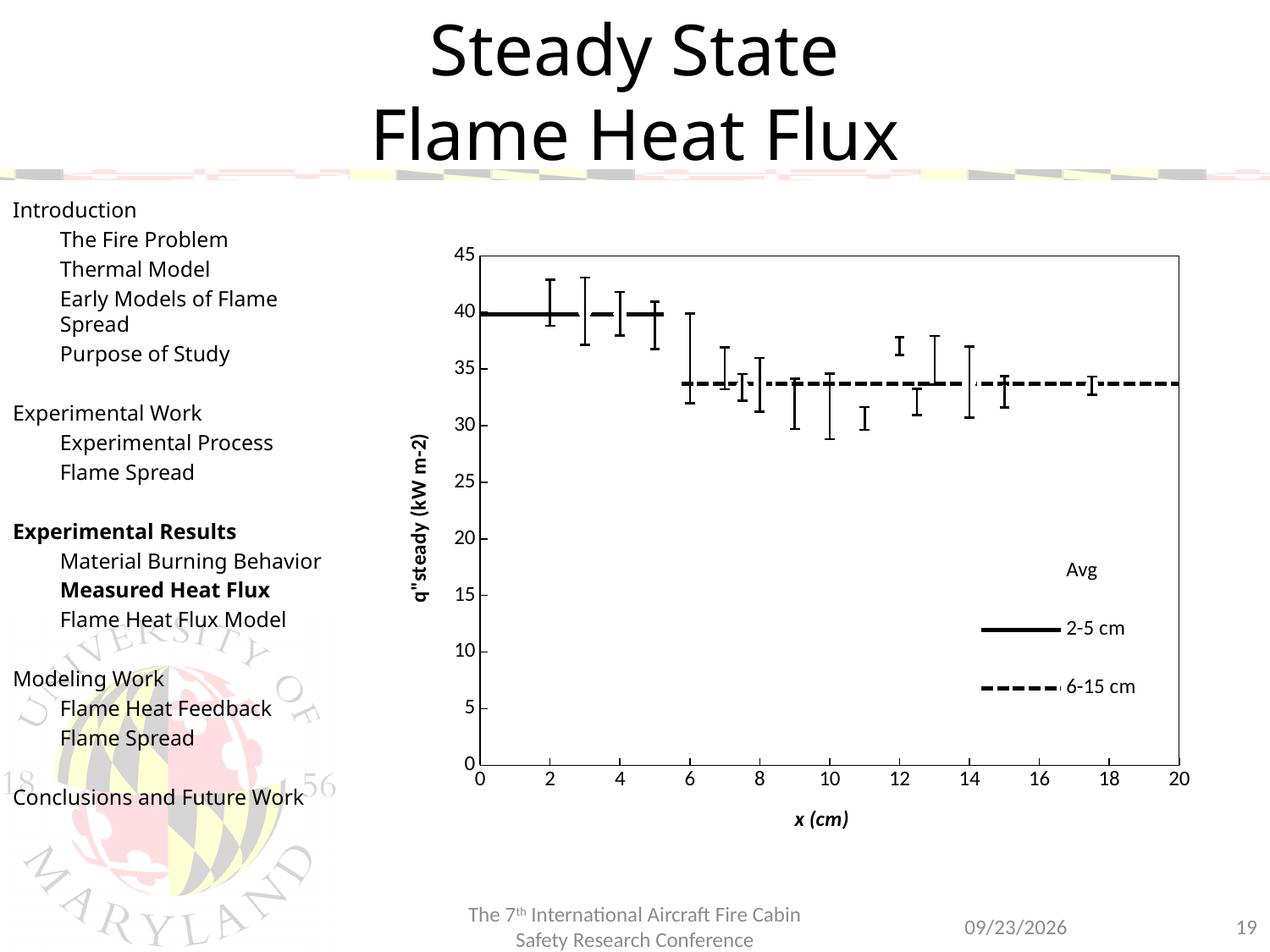
Which series in the legend is drawn with a dashed line? 6-15 cm Is the average value for the 2-5 cm series greater or less than 35? greater Is the average value for the 6-15 cm series greater or less than 35? less Is the average value for the 6-15 cm series greater or less than 30? greater How many series does the chart legend list? 3 What is the maximum value shown on the x axis of the chart? 20 What is the maximum value shown on the y axis of the chart? 45 Do the average heat flux values rise or fall as x increases along the x axis? fall Which series has the higher average line, 2-5 cm or 6-15 cm? 2-5 cm